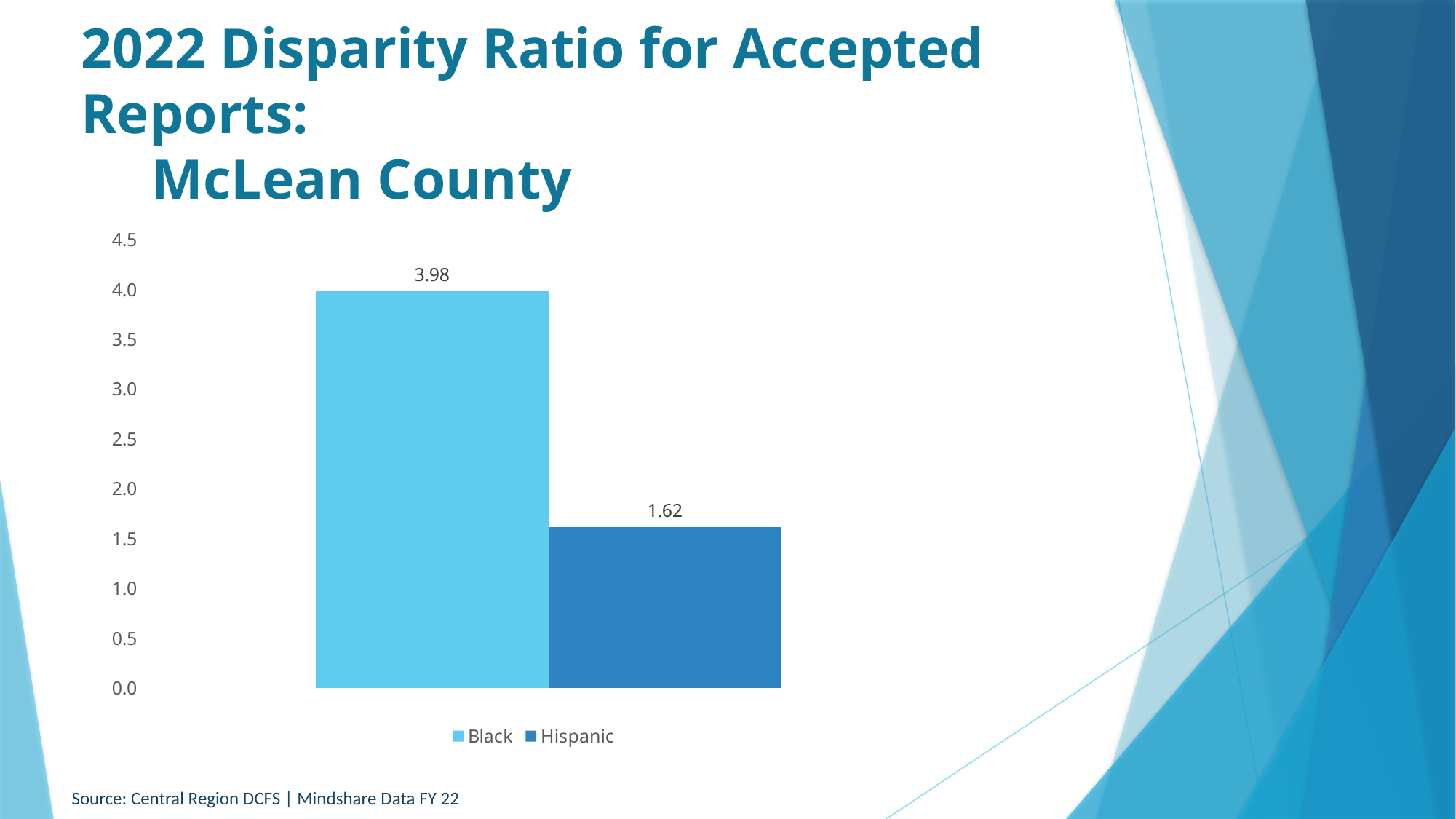
Which group has the highest disparity ratio? Black What is the disparity ratio for Hispanic? 1.62 Is the disparity ratio for Hispanic greater or less than 2.0? less What is the disparity ratio for Black? 3.98 What kind of chart is shown on the slide? bar chart What is the difference between the disparity ratios for Black and Hispanic? 2.36 Is the disparity ratio for Black greater or less than 3.5? greater How many bars are plotted in the chart? 2 What is the highest value shown on the vertical axis? 4.5 Which is larger, the disparity ratio for Black or for Hispanic? Black Which group has the lowest disparity ratio? Hispanic How many series does the legend list? 2